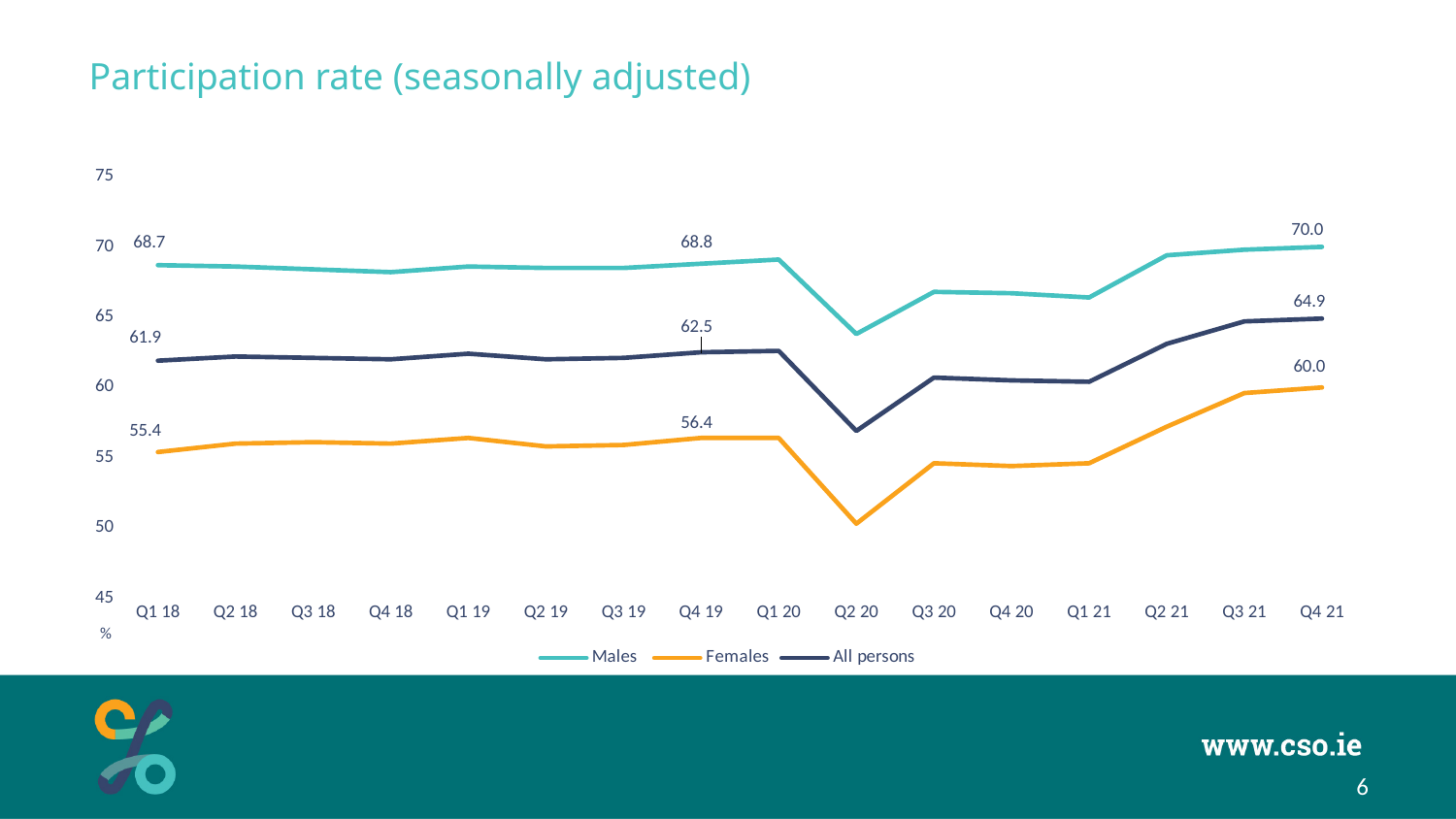
What is the title of the chart? Participation rate (seasonally adjusted) How many quarters are shown on the x axis? 16 What type of chart is shown on the slide? line chart By how much did the Females participation rate change from Q1 18 to Q4 21? 4.6 How many series does the legend list? 3 Which series has the highest participation rate in Q4 19? Males Is the Males participation rate in Q2 20 greater or less than 65? less What is the participation rate for Males in Q4 21? 70.0 What is the difference between the Males and Females participation rates in Q4 21? 10.0 What is the participation rate for All persons in Q4 19? 62.5 In which quarter does the Females line reach its lowest point? Q2 20 What is the participation rate for Females in Q1 18? 55.4